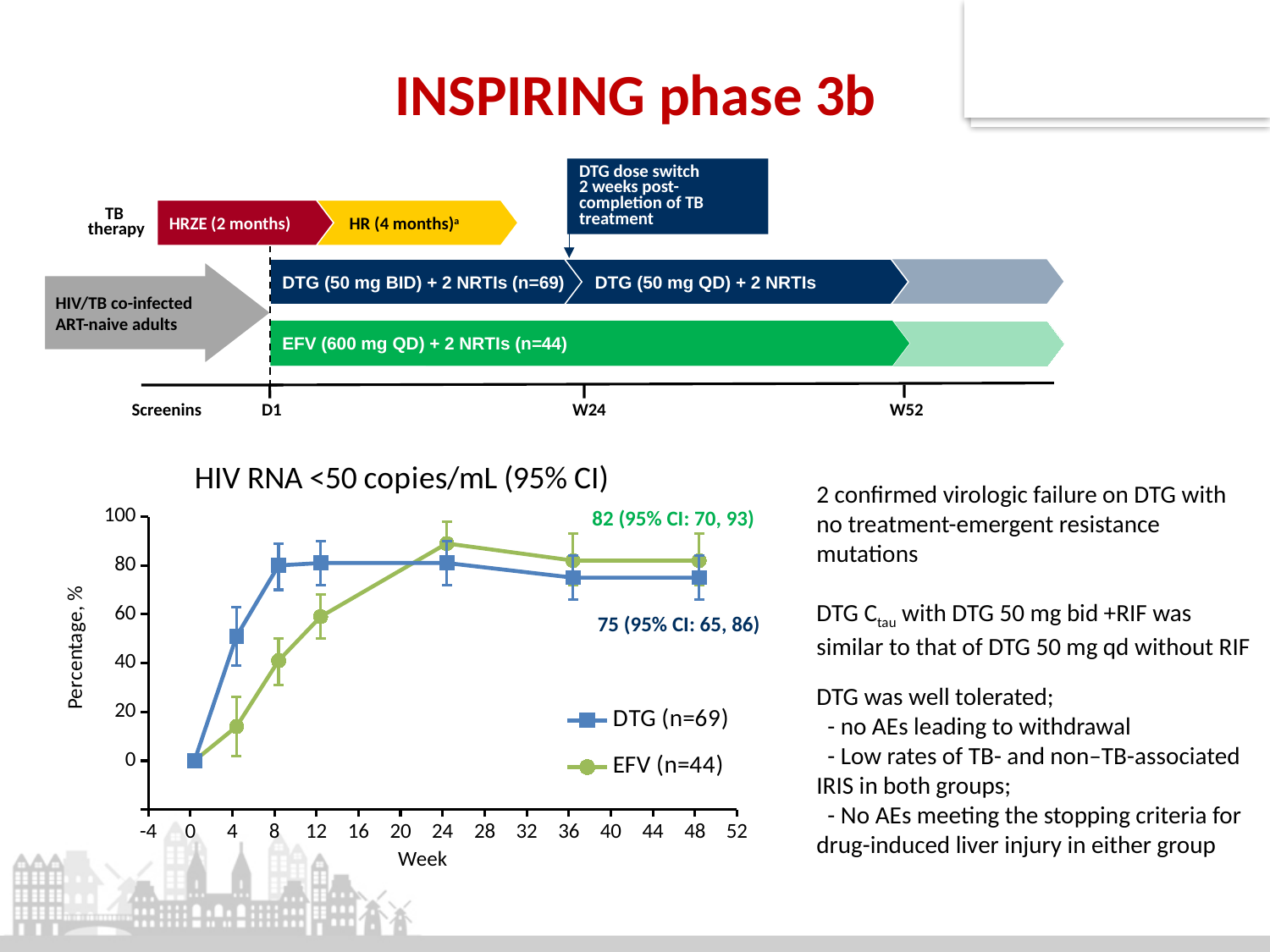
Does the EFV series rise or fall between week 0 and week 24? rise What is the percentage for DTG (n=69) at week 48? 75 What is the 95% CI shown for the EFV value at week 48? 70, 93 What kind of chart is shown on the slide? line chart What is the difference between the EFV and DTG percentages at week 48? 7 At week 4, which series has the higher percentage, DTG or EFV? DTG What is the title of the chart? HIV RNA <50 copies/mL (95% CI) What is the percentage for EFV (n=44) at week 48? 82 What is the 95% CI shown for the DTG value at week 48? 65, 86 Is the value for EFV at week 4 greater or less than 20? less How many series does the chart legend list? 2 Is the value for DTG at week 8 greater or less than 60? greater